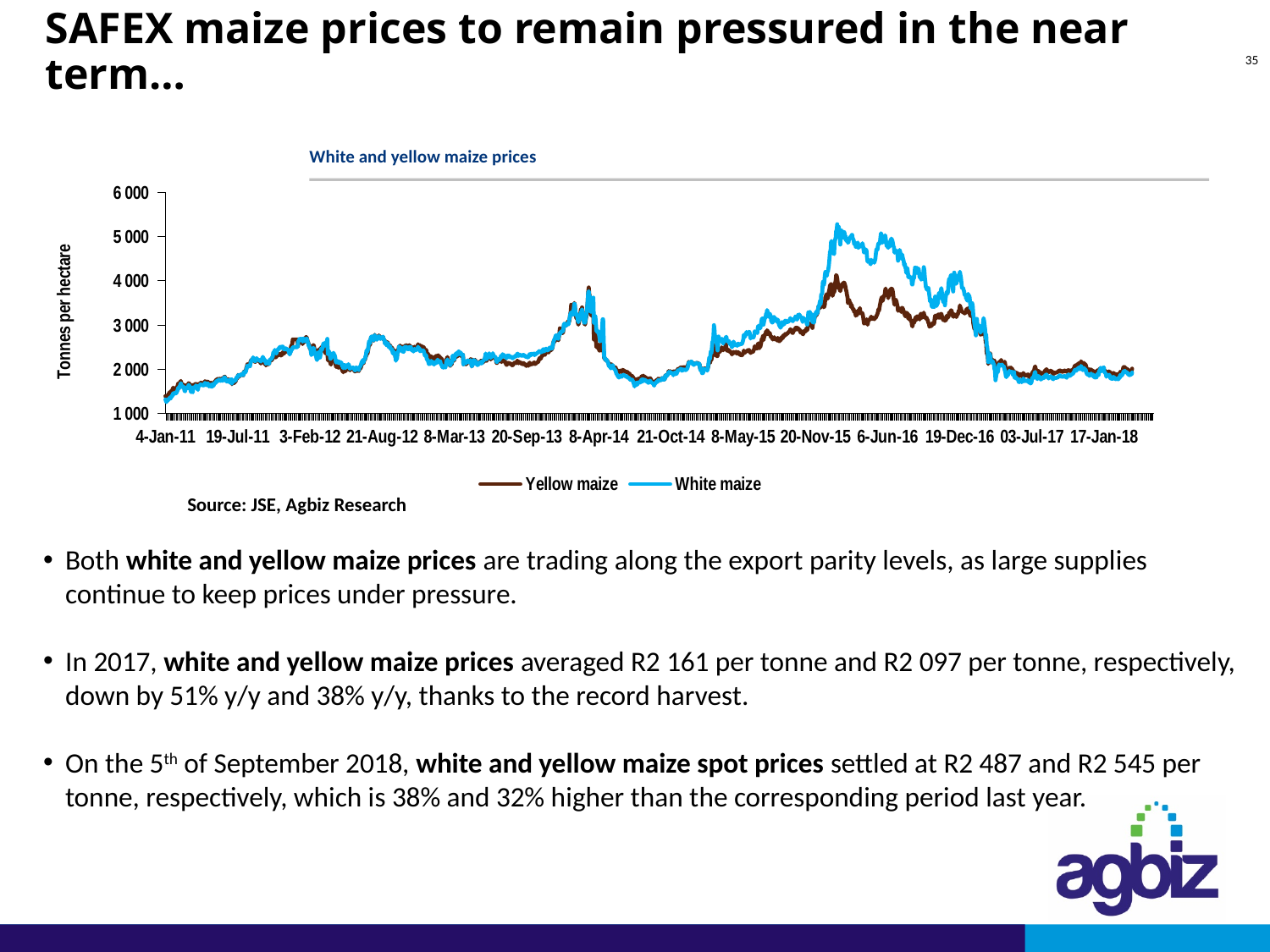
How many series does the legend of the chart list? 2 Is the value for White maize at 4-Jan-11 greater or less than 2 000? less What kind of chart is shown on the slide? Line chart Between 20-Nov-15 and 6-Jun-16, which series is higher, White maize or Yellow maize? White maize Is the peak value of the White maize line greater or less than 5 000? greater Is the peak value of the Yellow maize line greater or less than 5 000? less What are the two series listed in the chart's legend? Yellow maize and White maize Do the maize prices rise or fall overall between 4-Jan-11 and 3-Feb-12? rise Does the White maize price rise or fall overall between 6-Jun-16 and 17-Jan-18? fall Which series reaches the highest value on the chart? White maize What is the title of the chart? White and yellow maize prices